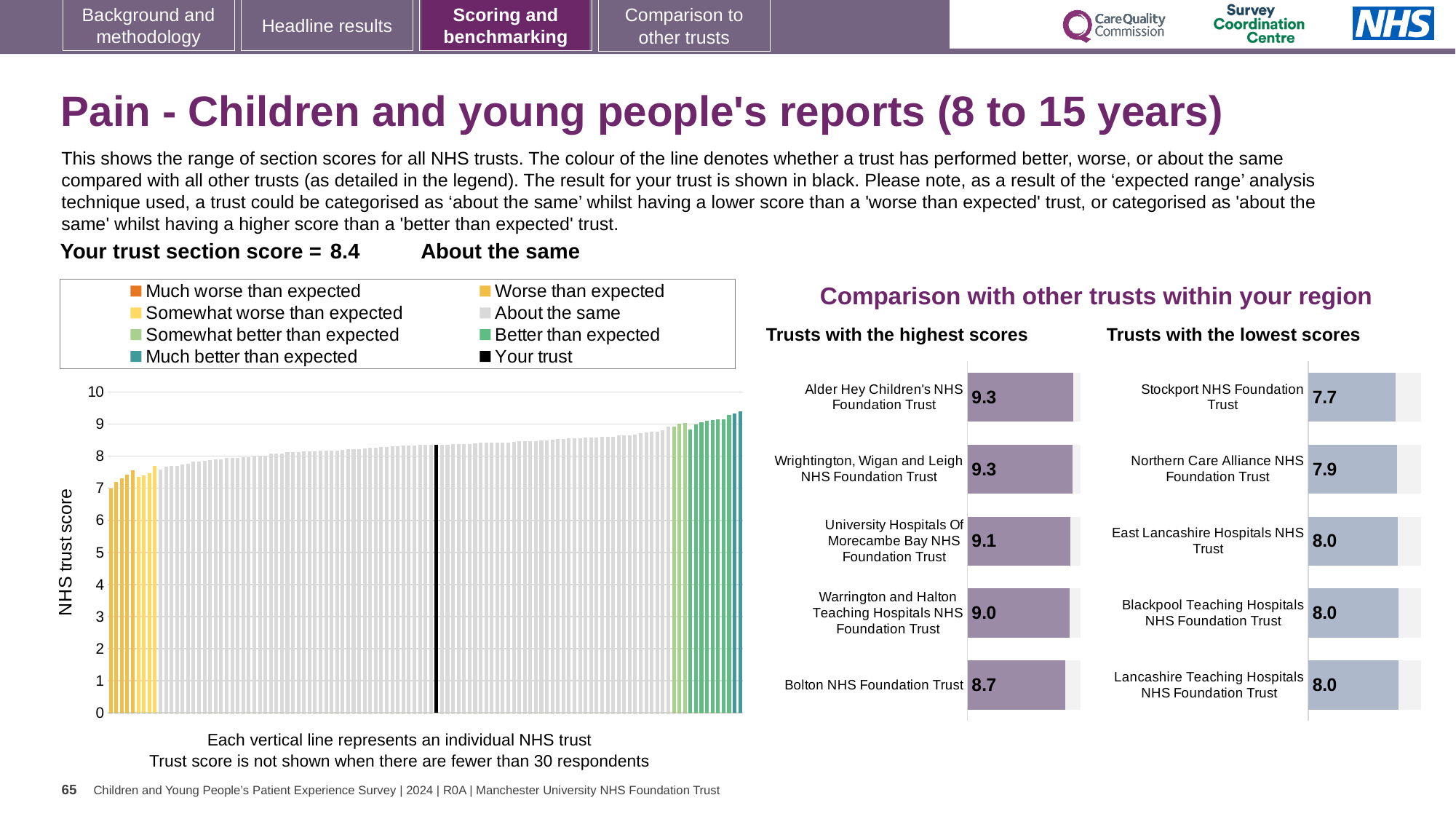
In the 'Trusts with the highest scores' chart, which trust has the lowest score? Bolton NHS Foundation Trust In the large chart on the left, do the bar heights rise or fall from left to right? Rise How many entries does the legend above the large chart on the left list? 8 In the large chart on the left, is the value of the black bar (your trust) greater or less than 8? greater How many trusts are shown in the 'Trusts with the lowest scores' chart? 5 In the 'Trusts with the highest scores' chart, what is the difference between the scores of Alder Hey Children's NHS Foundation Trust and Bolton NHS Foundation Trust? 0.6 In the 'Trusts with the highest scores' chart, what is the score for Bolton NHS Foundation Trust? 8.7 In the large chart on the left, what is the label on the vertical axis? NHS trust score In the 'Trusts with the highest scores' chart, what is the score for University Hospitals Of Morecambe Bay NHS Foundation Trust? 9.1 In the 'Trusts with the lowest scores' chart, what is the score for Stockport NHS Foundation Trust? 7.7 In the 'Trusts with the lowest scores' chart, which trust has the lowest score? Stockport NHS Foundation Trust What type of chart is the large chart on the left showing NHS trust scores? Bar chart